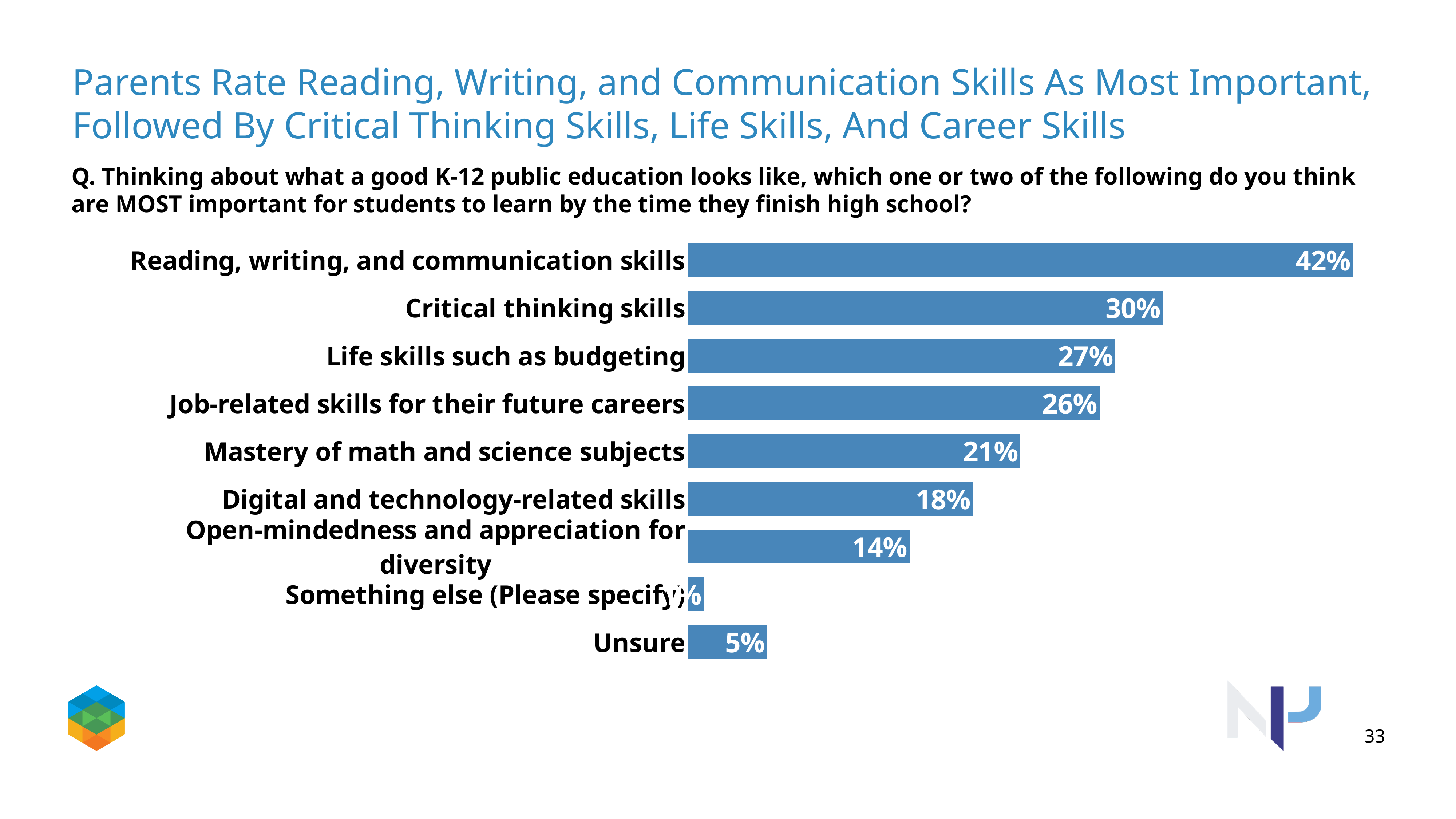
What percentage is shown for Mastery of math and science subjects? 21% Which category has the shortest bar in the chart? Something else (Please specify) How many categories are shown in the chart? 9 What is the value shown for Critical thinking skills? 30% What kind of chart is shown on the slide? Bar chart Which is larger: Life skills such as budgeting or Mastery of math and science subjects? Life skills such as budgeting What is the difference between Digital and technology-related skills and Unsure? 13% What is the difference between the values for Reading, writing, and communication skills and Critical thinking skills? 12% Which category has the highest value in the chart? Reading, writing, and communication skills What is the value for Open-mindedness and appreciation for diversity? 14% What percentage of parents answered Unsure? 5% What percentage of parents chose Reading, writing, and communication skills? 42%